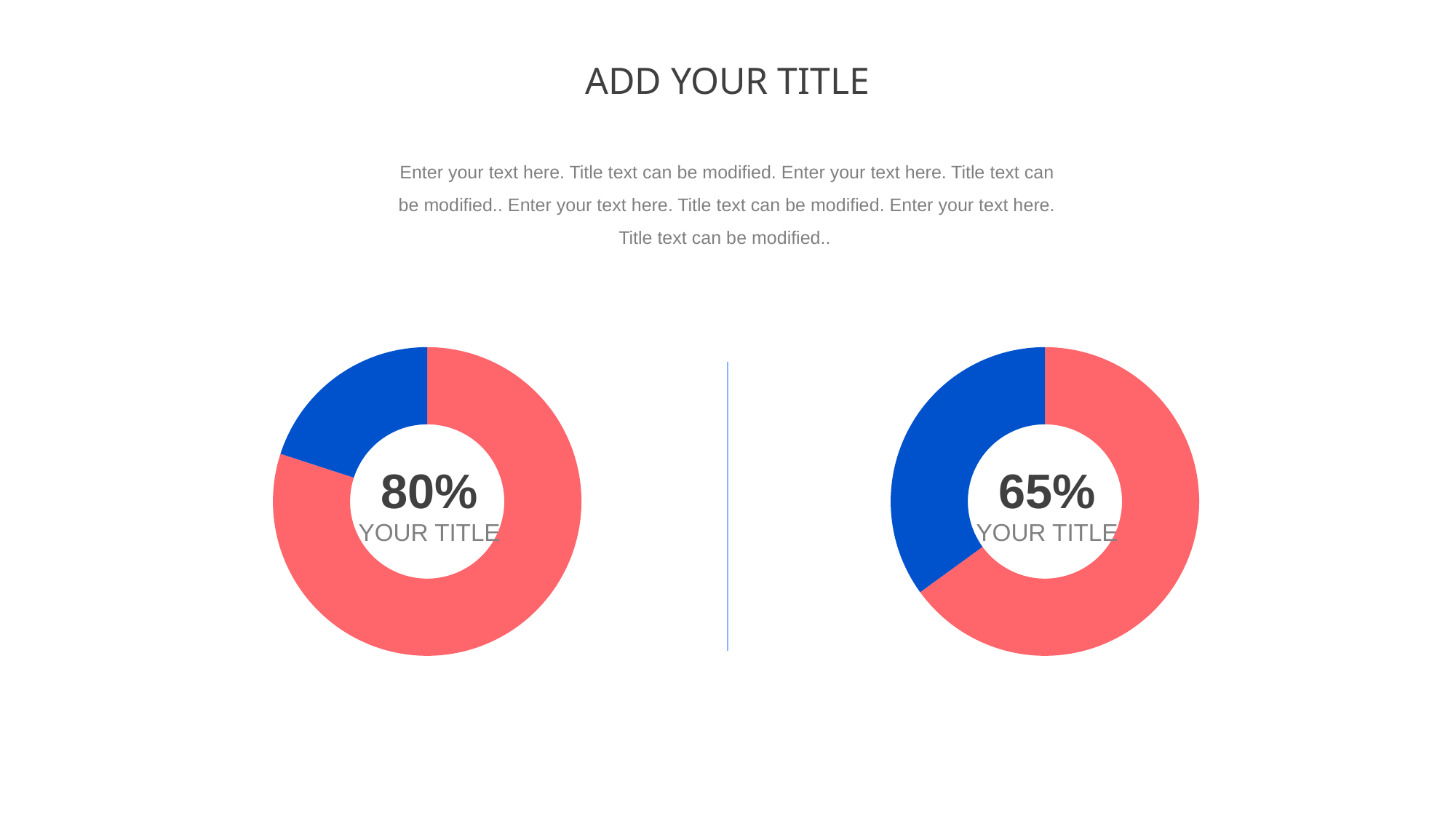
What percentage is shown in the centre of the right doughnut chart? 65% How many doughnut charts are on the slide? 2 What label appears below the percentage in the centre of each doughnut chart? YOUR TITLE In the right doughnut chart, what share of the ring does the red slice represent? 65% What is the difference between the percentage in the left doughnut chart and the percentage in the right doughnut chart? 15% What kind of chart is shown on the left side of the slide? Doughnut (pie) chart In the right doughnut chart, which slice is larger, the red one or the blue one? The red one Is the percentage shown in the right doughnut chart greater or less than 50%? greater Which doughnut chart shows the higher percentage, the left one or the right one? The left one In the left doughnut chart, what share of the ring does the red slice represent? 80% How many slices does the left doughnut chart have? 2 What percentage is shown in the centre of the left doughnut chart? 80%